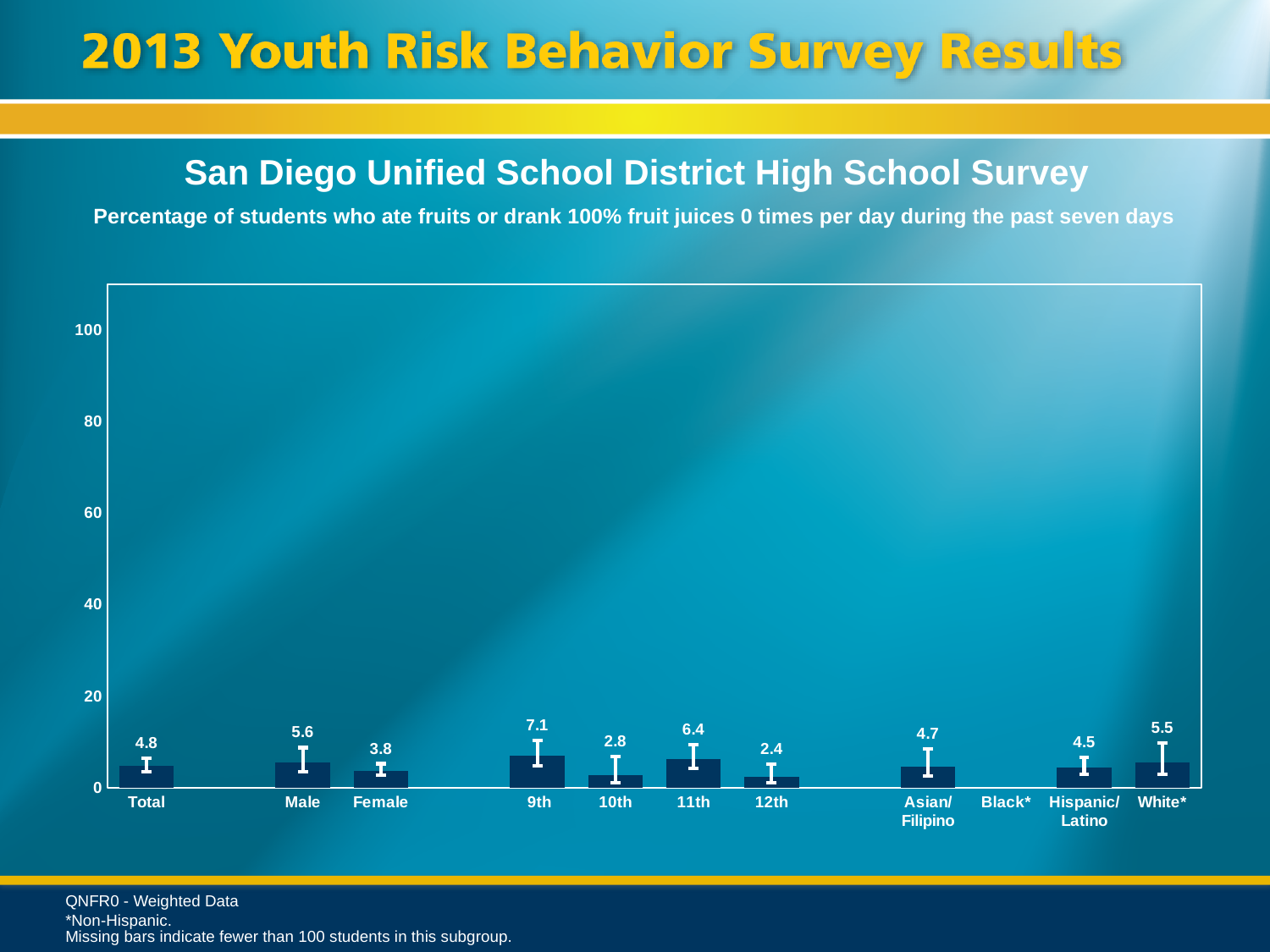
What kind of chart is shown? bar chart Is the value for White* greater or less than 20? less Which category has the highest value? 9th Which is larger, the value for 11th or the value for 10th? 11th How many categories are labeled on the x axis? 11 What is the value for Total? 4.8 What is the difference between the values for Male and Female? 1.8 What is the value for Hispanic/Latino? 4.5 What is the value for 9th grade? 7.1 Which category has no bar plotted? Black* What is the difference between the values for 9th and 12th? 4.7 Which category has the lowest plotted value? 12th